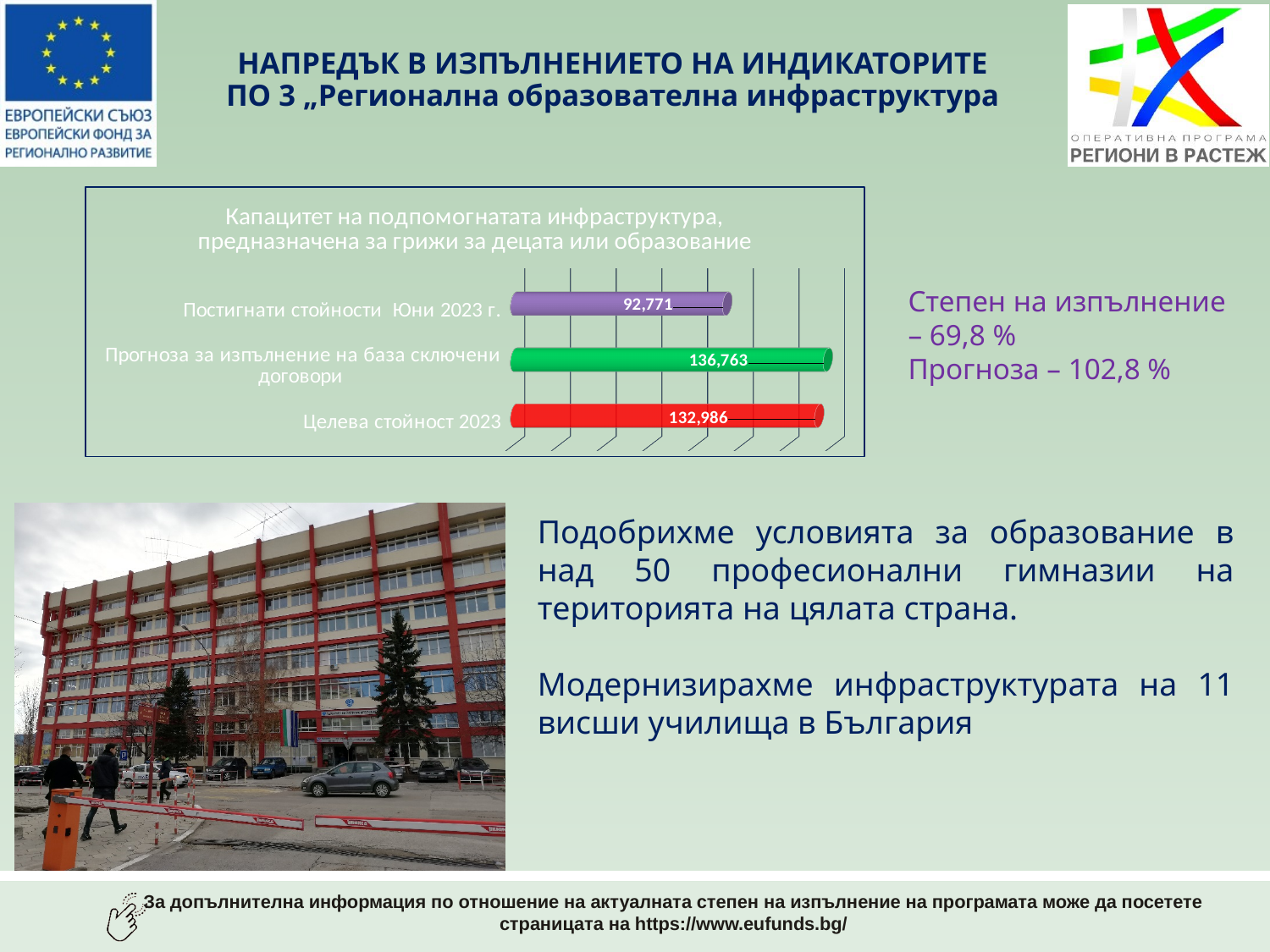
What kind of chart is shown on the slide? Bar chart What is the difference between the value for "Прогноза за изпълнение на база сключени договори" and the value for "Целева стойност 2023"? 3,777 What is the difference between the value for "Целева стойност 2023" and the value for "Постигнати стойности Юни 2023 г."? 40,215 Which category has the lowest value? Постигнати стойности Юни 2023 г. What is the value for "Постигнати стойности Юни 2023 г."? 92,771 What is the value for "Прогноза за изпълнение на база сключени договори"? 136,763 How many categories are shown in the chart? 3 What is the value for "Целева стойност 2023"? 132,986 What colour is the bar for "Целева стойност 2023"? Red Which category has the highest value? Прогноза за изпълнение на база сключени договори What is the difference between the value for "Прогноза за изпълнение на база сключени договори" and the value for "Постигнати стойности Юни 2023 г."? 43,992 Which is larger: the value for "Целева стойност 2023" or the value for "Постигнати стойности Юни 2023 г."? Целева стойност 2023